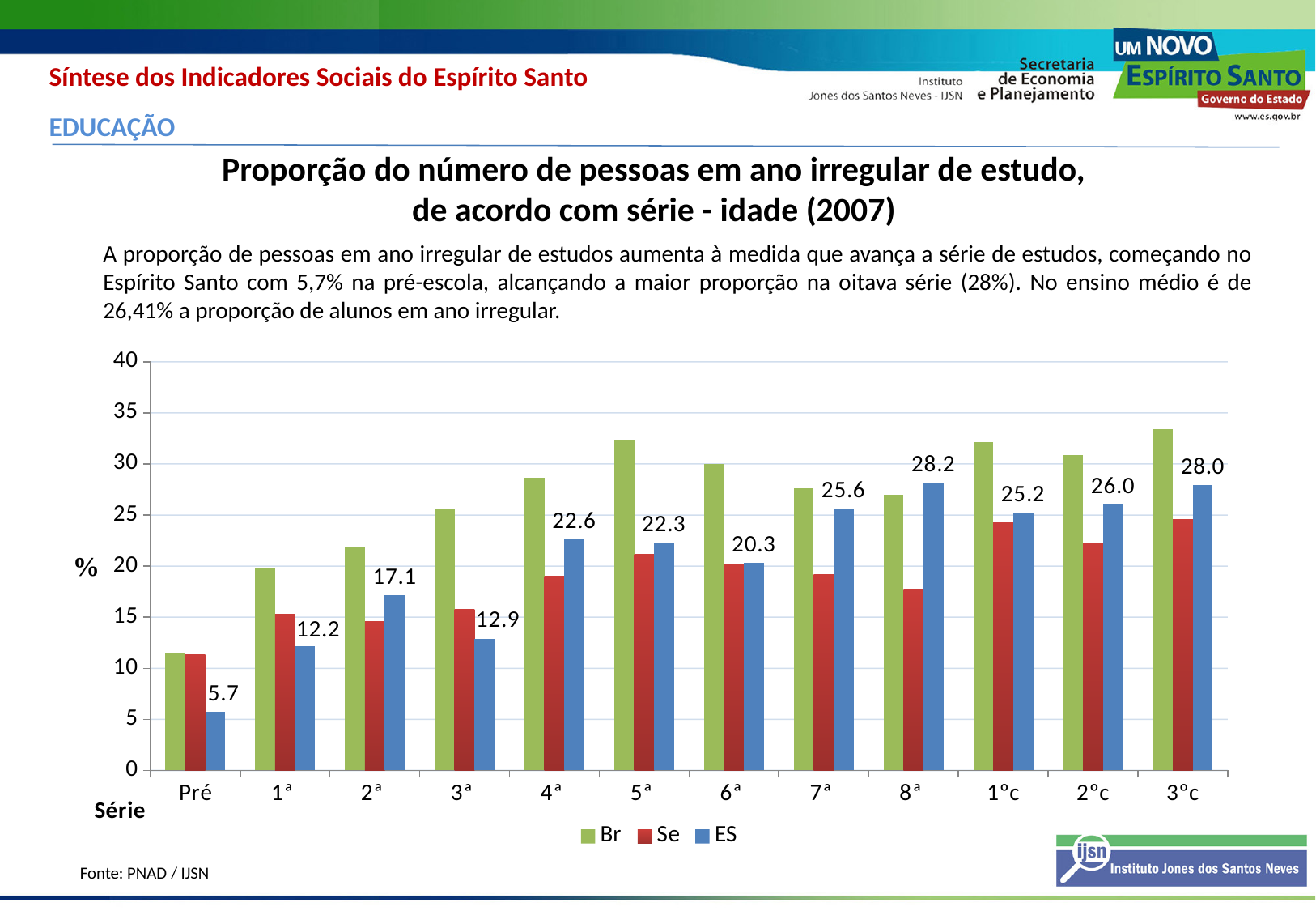
What kind of chart is shown on the slide? bar chart Which category has the lowest ES value? Pré How many categories are shown on the x axis? 12 How many series does the legend list? 3 What is the value for ES in the 8ª category? 28.2 Which is larger, the ES value for 4ª or the ES value for 3ª? 4ª Is the value for Se in the Pré category greater or less than 15? less What is the value for ES in the 2°c category? 26.0 Is the value for Br in the 5ª category greater or less than 30? greater What is the difference between the ES values for 8ª and Pré? 22.5 What is the value for ES in the Pré category? 5.7 Which category has the highest ES value? 8ª